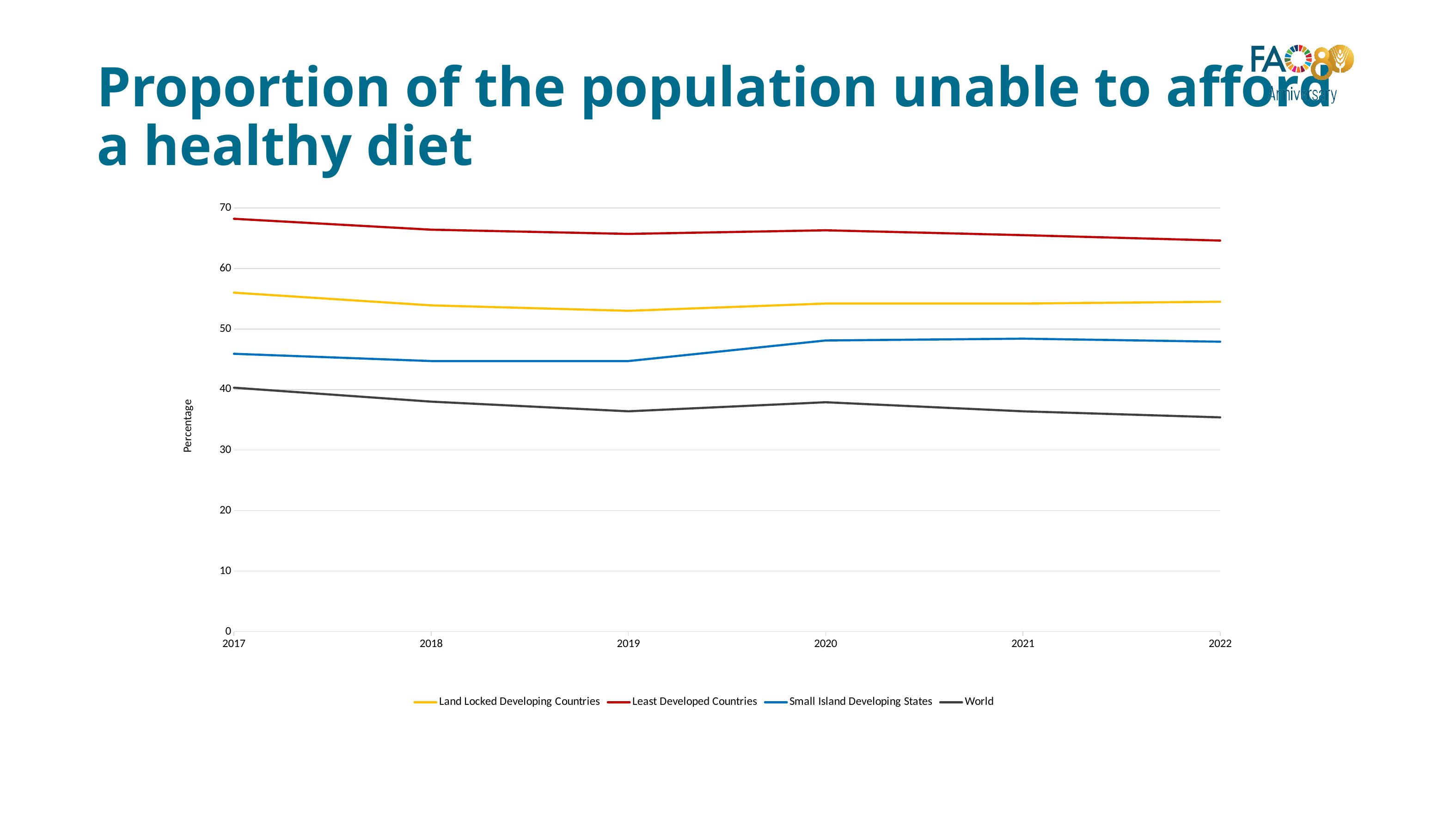
What is the label on the vertical axis? Percentage Which series has the lowest values across all years? World Which series has the highest values across all years? Least Developed Countries Is the value for Least Developed Countries in 2017 greater or less than 60? greater Is the value for Land Locked Developing Countries in 2019 greater or less than 50? greater Is the value for World in 2022 greater or less than 40? less How many series does the legend list? 4 Does the Least Developed Countries line rise or fall overall from 2017 to 2022? fall How many years are shown along the x axis? 6 In 2020, which is larger: Land Locked Developing Countries or Small Island Developing States? Land Locked Developing Countries What kind of chart is shown on the slide? line chart